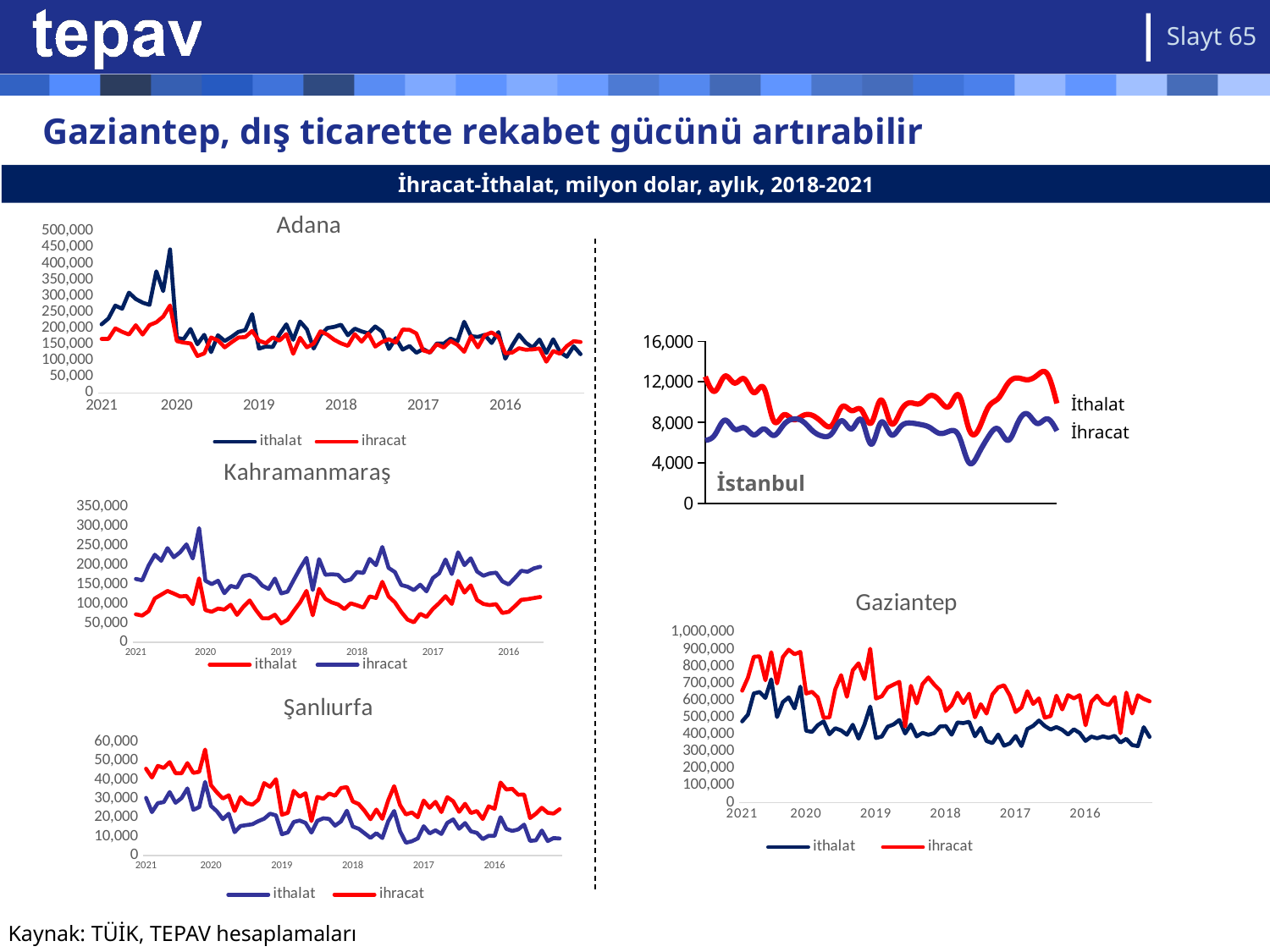
In the Adana chart, is the highest value of ihracat greater or less than 300,000? less In the Adana chart, is ithalat higher at the 2021 end or at the 2016 end of the x axis? 2021 end In the Gaziantep chart, which series is higher across the period, ithalat or ihracat? ihracat How many series does the legend of the Adana chart list? 2 In the Şanlıurfa chart, is the highest value of ihracat greater or less than 50,000? greater In the Gaziantep chart, is the highest value of ihracat greater or less than 800,000? greater What are the two series named in the legend of the Şanlıurfa chart? ithalat and ihracat What kind of chart is the Gaziantep chart? line chart How many city charts are shown on the slide? 5